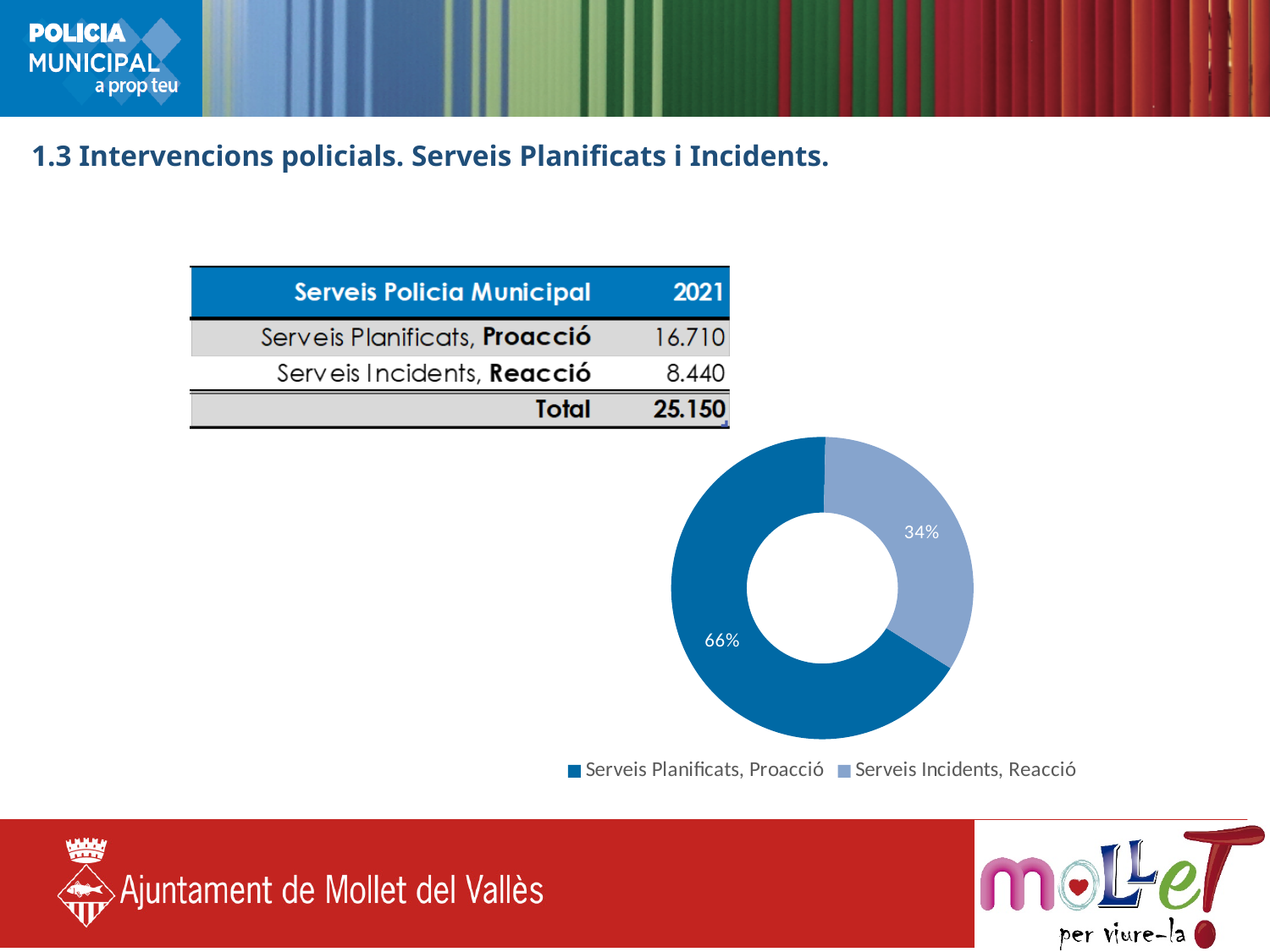
Which legend entry is shown in dark blue in the pie chart? Serveis Planificats, Proacció How many entries does the legend of the pie chart list? 2 Which slice of the pie chart is the largest? Serveis Planificats, Proacció Which colour represents Serveis Incidents, Reacció in the pie chart? Light blue What kind of chart is shown on the slide? Pie chart (donut) Which is larger in the pie chart: Serveis Planificats, Proacció or Serveis Incidents, Reacció? Serveis Planificats, Proacció By how many percentage points does the Serveis Planificats, Proacció share exceed the Serveis Incidents, Reacció share in the pie chart? 32 percentage points How many slices does the pie chart have? 2 What share of the pie chart does Serveis Incidents, Reacció represent? 34% Which slice of the pie chart is the smallest? Serveis Incidents, Reacció What share of the pie chart does Serveis Planificats, Proacció represent? 66%